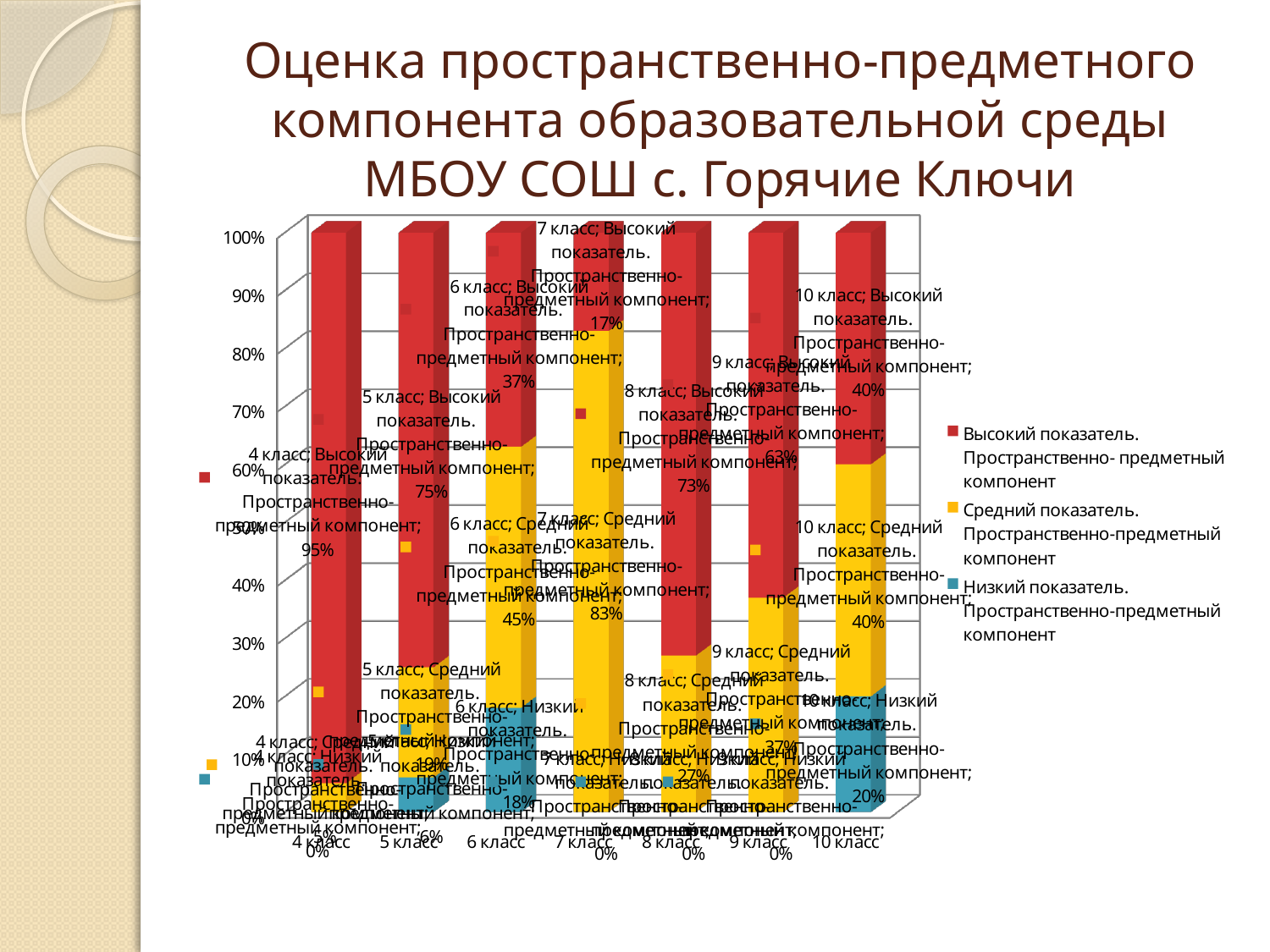
How many classes (categories) are shown on the x axis? 7 Which class has the highest value for 'Высокий показатель'? 4 класс How many series does the legend list? 3 What is the value of 'Высокий показатель' for 4 класс? 95% Which is larger: 'Высокий показатель' for 6 класс or 'Средний показатель' for 6 класс? Средний показатель for 6 класс What colour represents 'Низкий показатель' in the chart? Blue What is the value of 'Низкий показатель' for 6 класс? 18% What is the value of 'Средний показатель' for 7 класс? 83% Which class has the lowest value for 'Высокий показатель'? 7 класс What is the value of 'Высокий показатель' for 9 класс? 63% What kind of chart is shown on the slide? Stacked bar chart What is the difference between 'Высокий показатель' for 8 класс (73%) and 'Средний показатель' for 8 класс (27%)? 46%